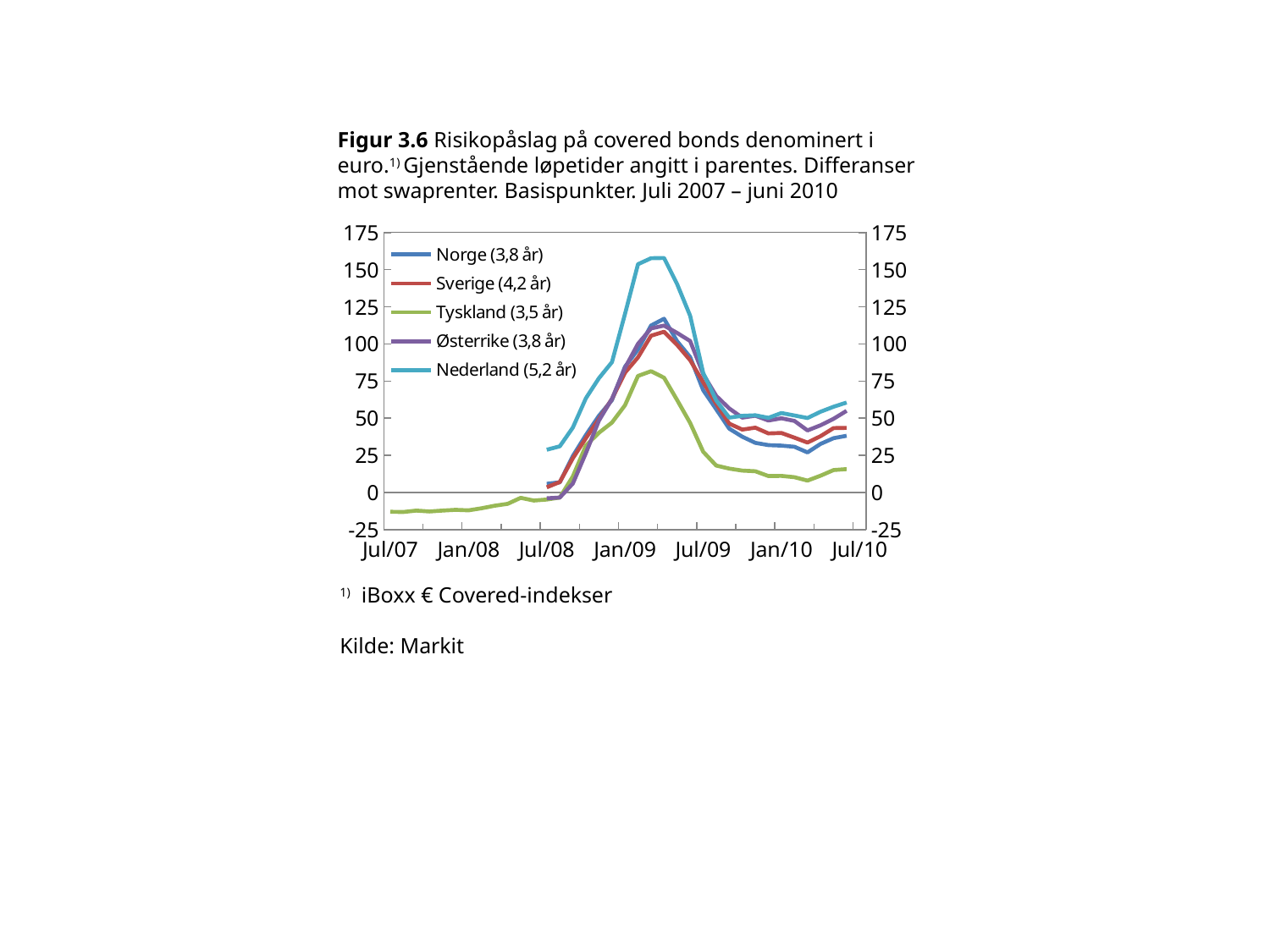
What source is cited below the chart? Markit At Jan/09, which series is higher: Nederland (5,2 år) or Tyskland (3,5 år)? Nederland (5,2 år) What kind of chart is shown on the slide? line chart Does the Tyskland (3,5 år) series rise or fall between its peak in early 2009 and Jul/09? fall Which series reaches the highest value on the chart? Nederland (5,2 år) Is the peak value of the Tyskland (3,5 år) series greater or less than 100? less Is the value of the Tyskland (3,5 år) series at Jul/07 greater or less than 0? less Is the peak value of the Nederland (5,2 år) series greater or less than 150? greater What is the maximum value shown on the vertical axis? 175 Which series has the lowest value at the end of the period (Jul/10)? Tyskland (3,5 år) How many series does the legend list? 5